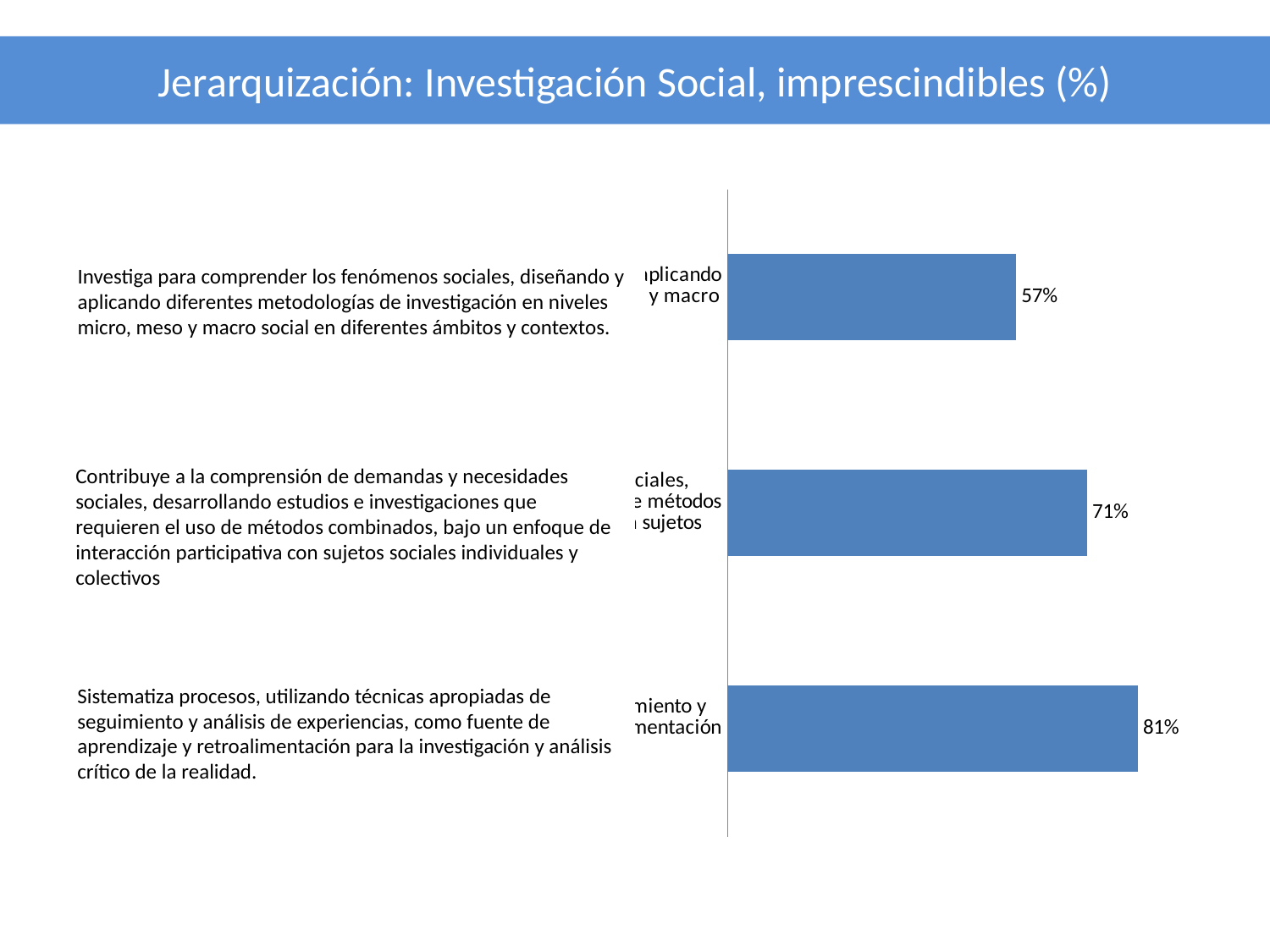
Which category has the highest value? Sistematiza procesos, utilizando técnicas apropiadas de seguimiento y análisis de experiencias What colour are the bars in the chart? Blue Which is larger: the value for "Contribuye a la comprensión de demandas" or the value for "Investiga para comprender los fenómenos sociales"? Contribuye a la comprensión de demandas What is the value for the category beginning "Contribuye a la comprensión de demandas y necesidades sociales"? 71% What is the difference between the values for "Sistematiza procesos" and "Contribuye a la comprensión de demandas"? 10% What is the difference between the highest value (81%) and the lowest value (57%)? 24% What is the value for the category beginning "Investiga para comprender los fenómenos sociales"? 57% What is the value for the category beginning "Sistematiza procesos, utilizando técnicas apropiadas"? 81% What kind of chart is shown on the slide? Bar chart What is the title of the slide? Jerarquización: Investigación Social, imprescindibles (%) How many bars are plotted in the chart? 3 Which category has the lowest value? Investiga para comprender los fenómenos sociales